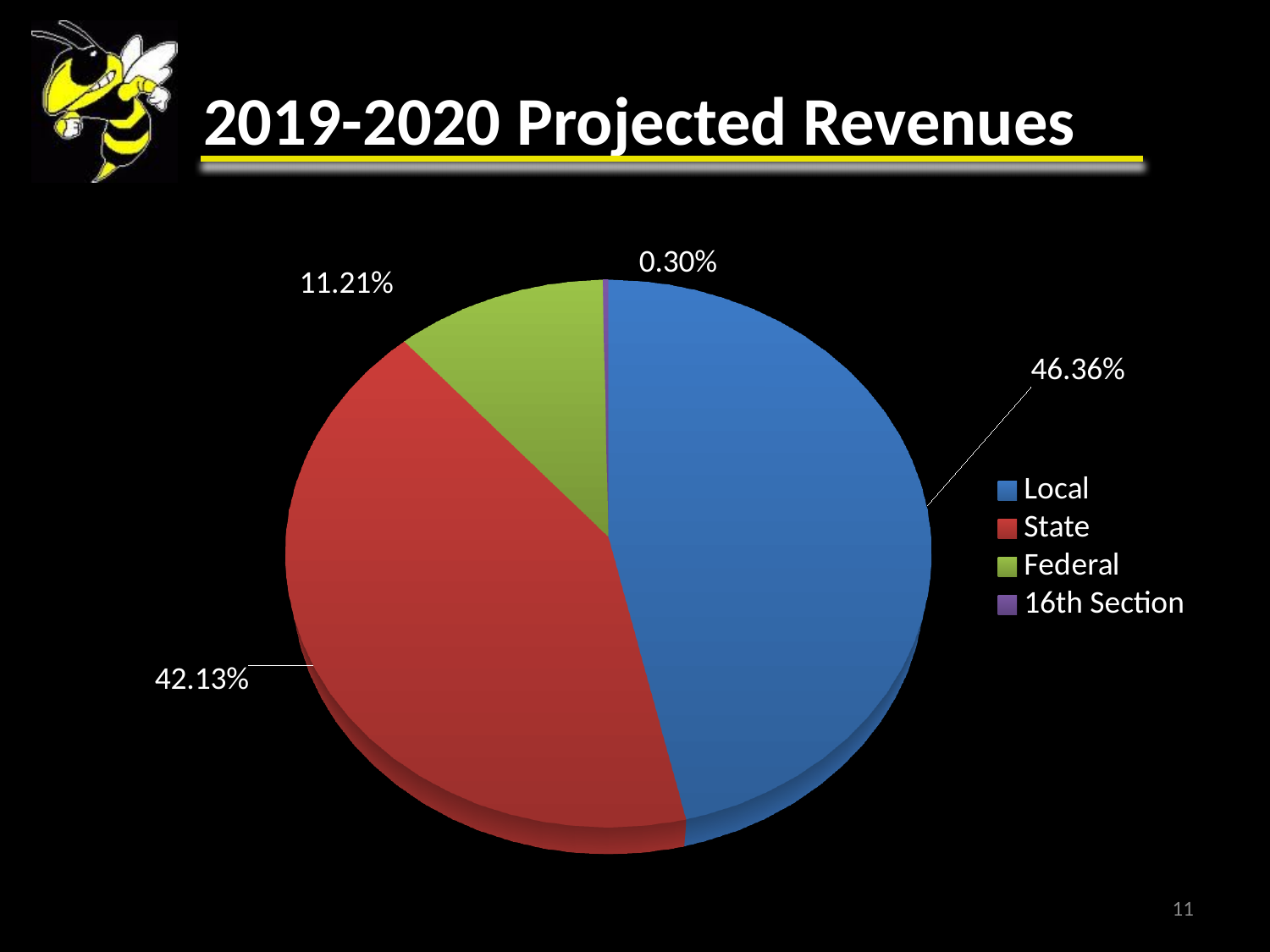
What is the difference in percentage points between the Local and State shares? 4.23 Which revenue source has the smallest share? 16th Section What share of projected revenues comes from Federal sources? 11.21% What is the title of the slide containing the chart? 2019-2020 Projected Revenues What share of projected revenues comes from 16th Section? 0.30% What is the difference in percentage points between the Federal and 16th Section shares? 10.91 What share of projected revenues comes from Local sources? 46.36% How many revenue categories are shown in the pie chart? 4 What kind of chart is shown on the slide? Pie chart Which is larger, the State share or the Federal share? State Which revenue source has the largest share? Local